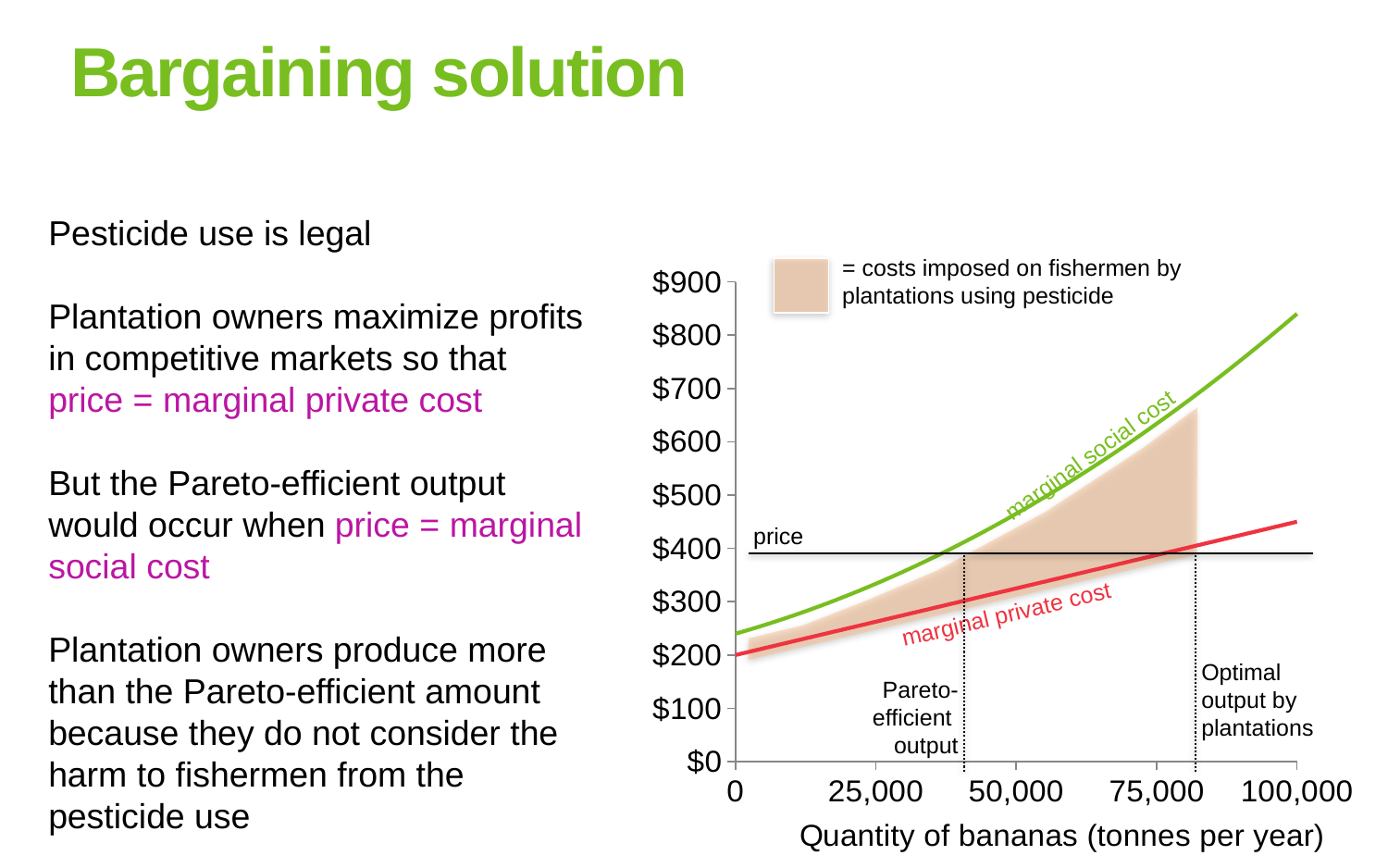
At 100,000 tonnes per year, is the marginal social cost greater or less than $800? greater At 100,000 tonnes per year, is the marginal private cost greater or less than $500? less Is the price line greater or less than $500? less At 75,000 tonnes per year, which is higher: marginal social cost or marginal private cost? marginal social cost Does the marginal private cost line rise or fall as the quantity of bananas increases? rise What does the shaded area in the chart represent? costs imposed on fishermen by plantations using pesticide What kind of chart is shown on the slide? line chart What is the title of the x axis of the chart? Quantity of bananas (tonnes per year) Does the marginal social cost curve rise or fall as the quantity of bananas increases? rise Which is larger: the Pareto-efficient output or the optimal output by plantations? optimal output by plantations